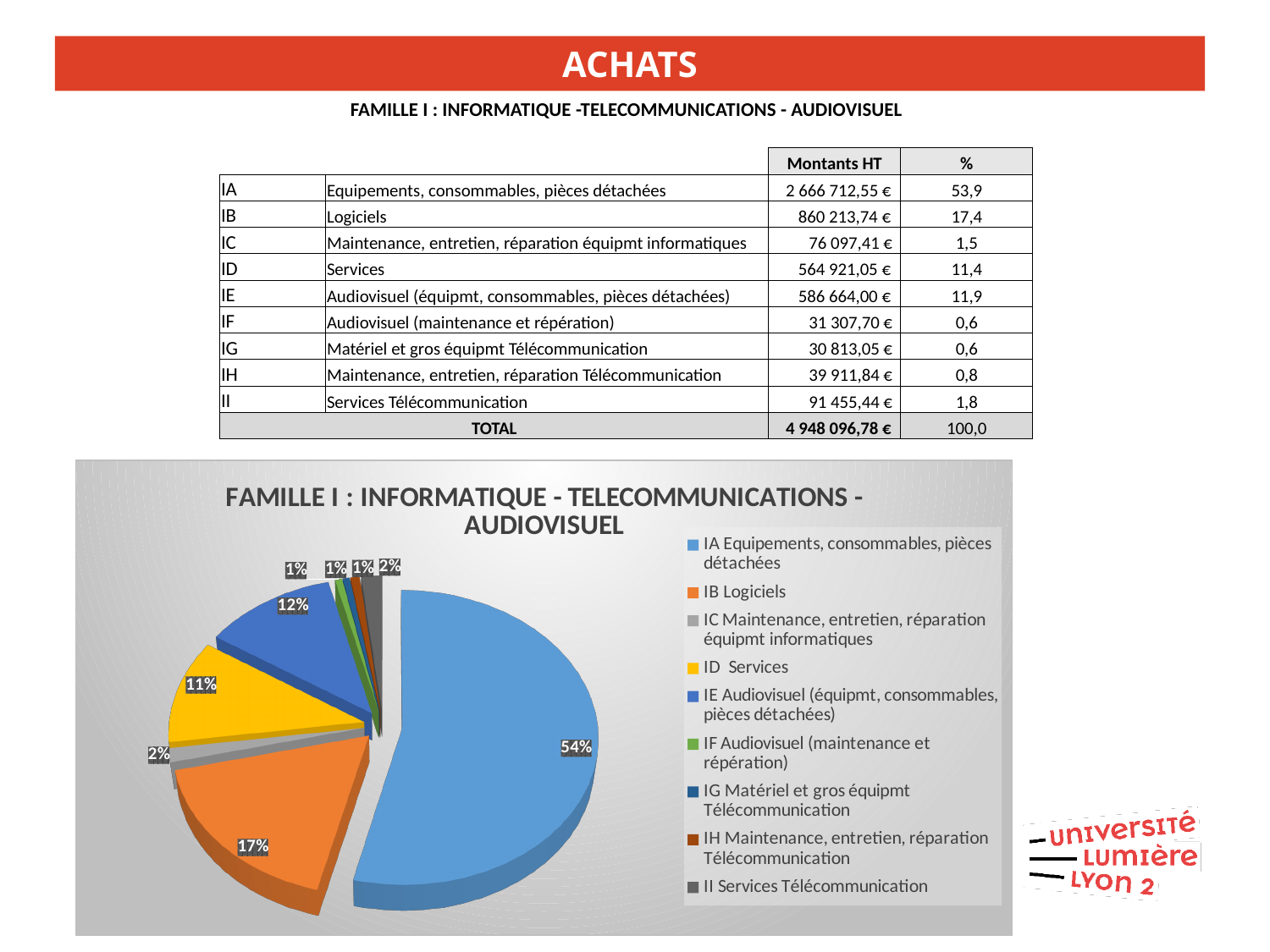
How many entries does the chart legend list? 9 How many slices does the pie chart have? 9 What is the difference in percentage points between the IA slice and the IB slice? 37 What kind of chart is shown on the slide? Pie chart What share of the pie does IB Logiciels represent? 17% What share of the pie does IE Audiovisuel (équipmt, consommables, pièces détachées) represent? 12% What share of the pie does IA Equipements, consommables, pièces détachées represent? 54% What share of the pie does II Services Télécommunication represent? 2% What is the title of the pie chart? FAMILLE I : INFORMATIQUE - TELECOMMUNICATIONS - AUDIOVISUEL Which category has the largest slice of the pie? IA Equipements, consommables, pièces détachées What share of the pie does ID Services represent? 11% Which slice is larger: IB Logiciels or IE Audiovisuel (équipmt, consommables, pièces détachées)? IB Logiciels